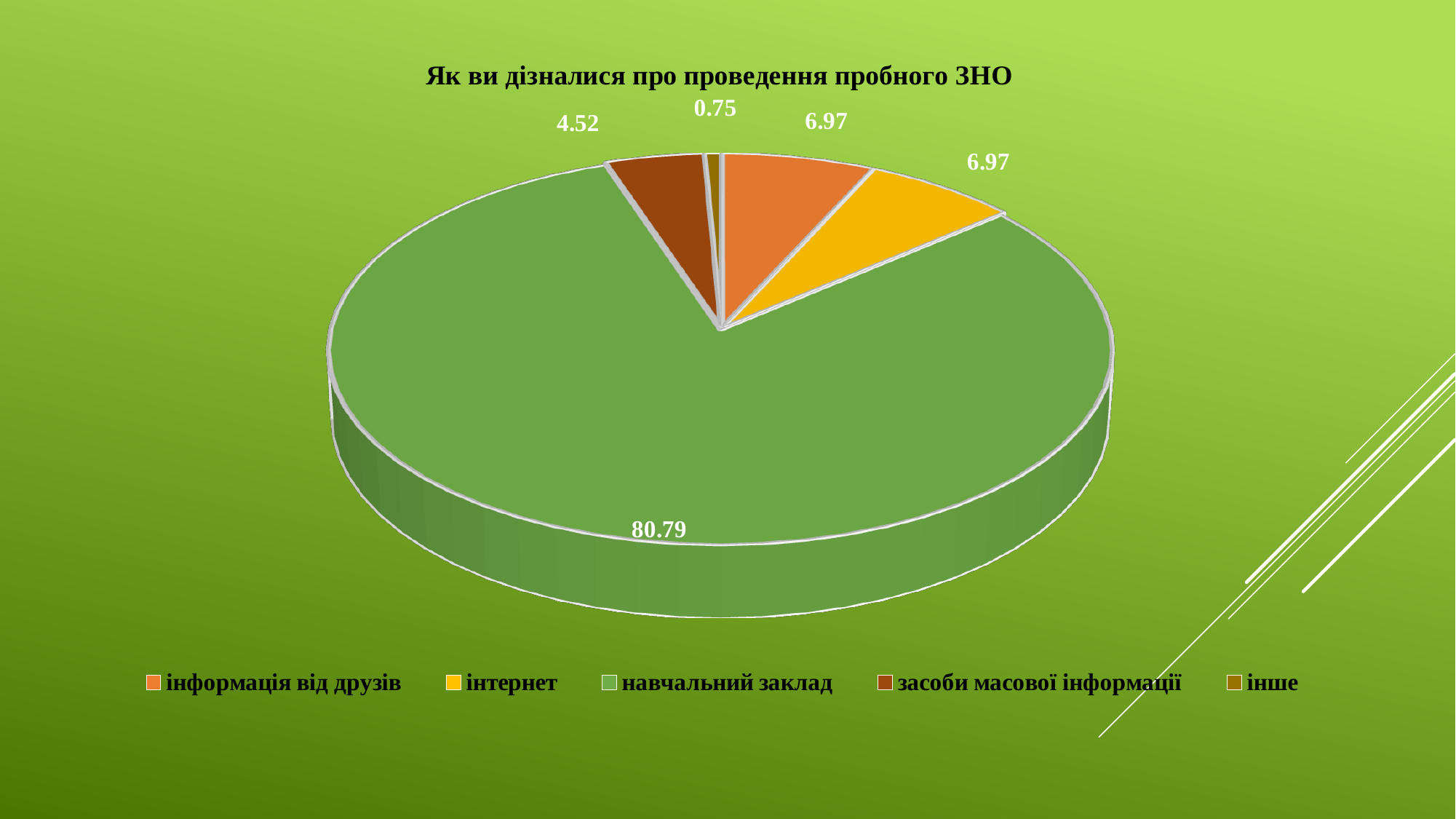
What is the value for засоби масової інформації? 4.52 Which category has the smallest slice? інше What kind of chart is shown on the slide? pie chart How many categories does the legend list? 5 What is the value for інтернет? 6.97 What is the title of the chart? Як ви дізналися про проведення пробного ЗНО Which colour represents інтернет in the chart? yellow Which is larger, the value for засоби масової інформації or the value for інше? засоби масової інформації What is the value for інше? 0.75 What is the difference between the values for навчальний заклад and інформація від друзів? 73.82 Which category has the largest slice? навчальний заклад What is the value for навчальний заклад? 80.79